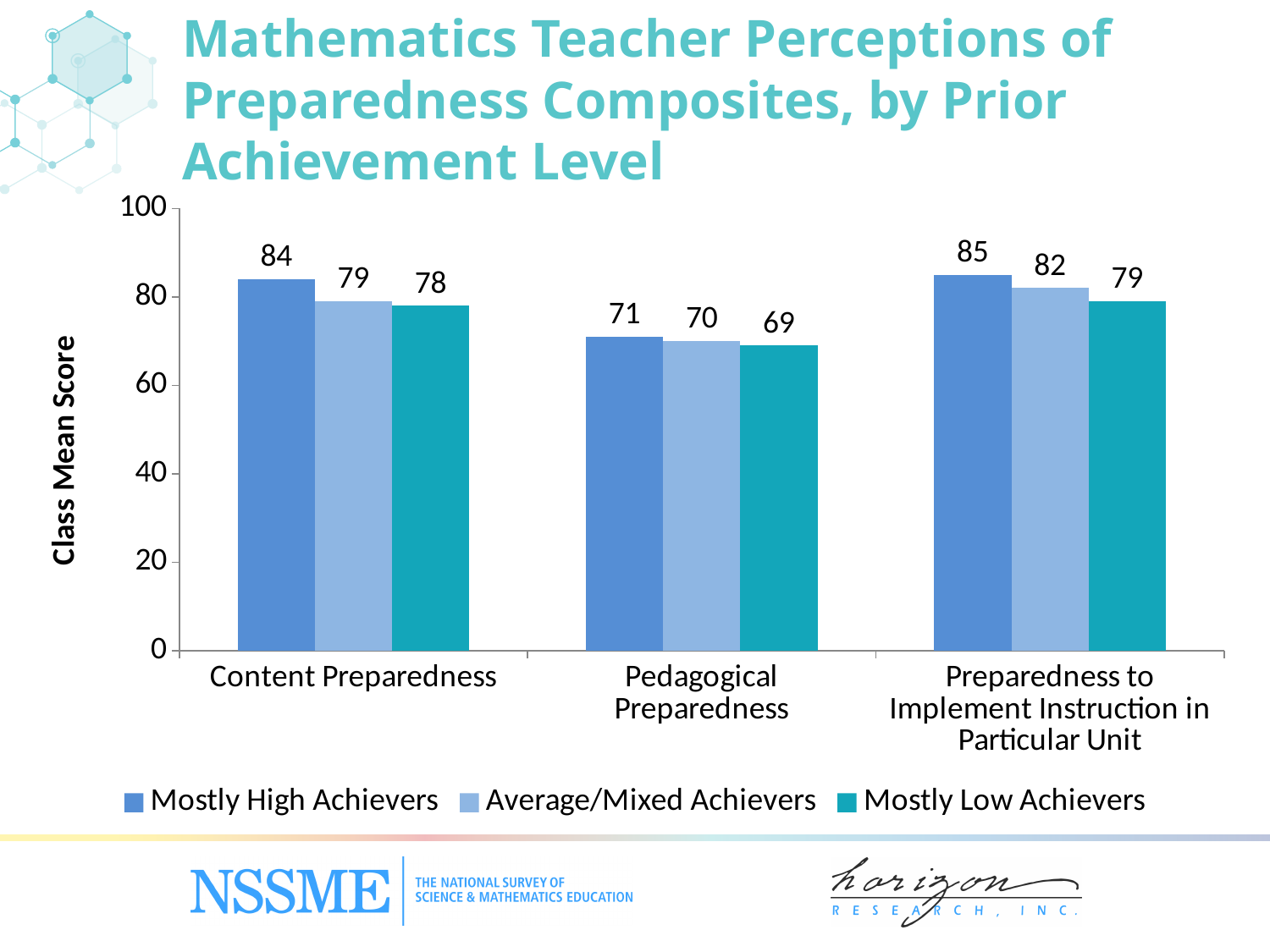
What is the difference between the Mostly High Achievers and Mostly Low Achievers scores on Content Preparedness? 6 How many categories are shown on the x axis? 3 Which category has the highest Class Mean Score for Mostly High Achievers? Preparedness to Implement Instruction in Particular Unit What is the Class Mean Score for Average/Mixed Achievers on Preparedness to Implement Instruction in Particular Unit? 82 Which category has the lowest Class Mean Score for Mostly Low Achievers? Pedagogical Preparedness Is the Mostly Low Achievers score on Pedagogical Preparedness greater or less than 80? less What is the Class Mean Score for Mostly Low Achievers on Pedagogical Preparedness? 69 How many series does the legend list? 3 Which is larger: the Average/Mixed Achievers score on Content Preparedness or on Pedagogical Preparedness? Content Preparedness What is the difference between the Mostly High Achievers score on Preparedness to Implement Instruction in Particular Unit and on Pedagogical Preparedness? 14 What kind of chart is shown on the slide? bar chart What is the Class Mean Score for Mostly High Achievers on Content Preparedness? 84